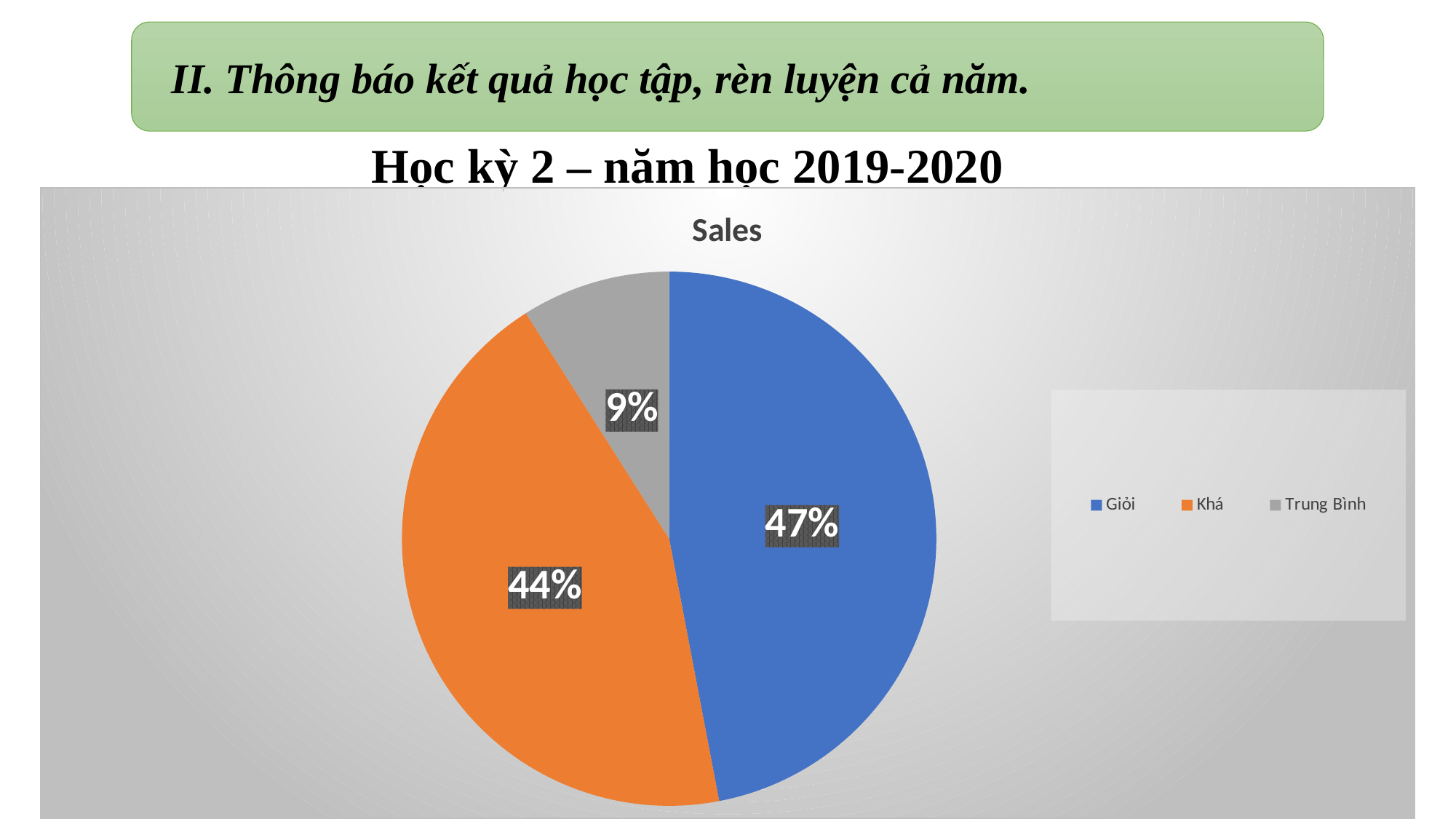
What share of the pie does Trung Bình take? 9% What is the chart's title? Sales How many categories are shown in the pie chart? 3 What share of the pie does Giỏi take? 47% Which category has the largest slice of the pie? Giỏi Which is larger, the Khá slice or the Trung Bình slice? Khá What share of the pie does Khá take? 44% What is the difference in percentage points between the Khá and Trung Bình slices? 35% What is the difference in percentage points between the Giỏi and Khá slices? 3% Which colour represents Khá in the legend? orange What kind of chart is shown on the slide? pie chart Which category has the smallest slice of the pie? Trung Bình